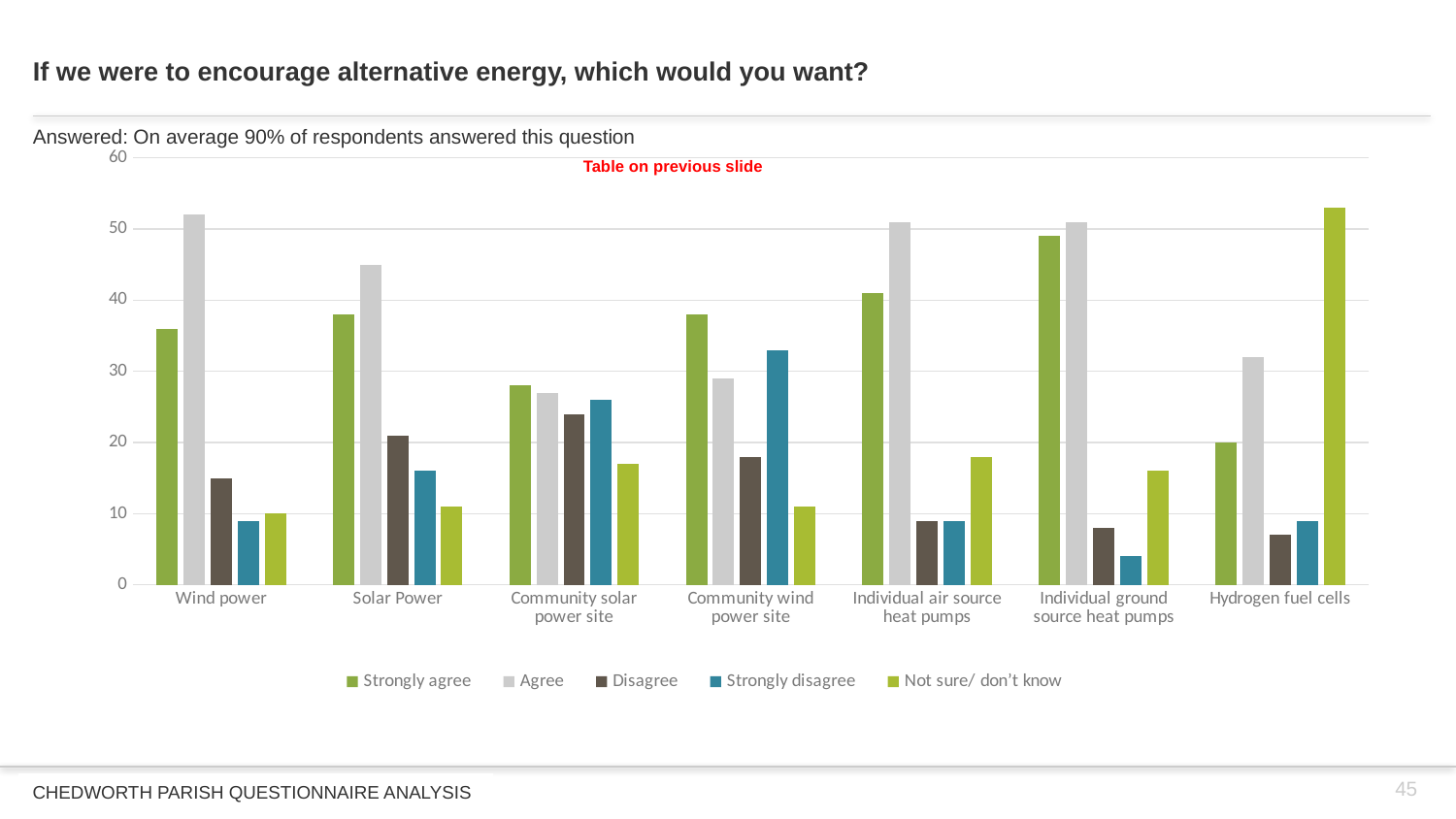
Is the 'Strongly disagree' value for Community solar power site greater or less than 20? greater Which energy option has the highest 'Strongly agree' bar? Individual ground source heat pumps Which energy option has the lowest 'Strongly disagree' bar? Individual ground source heat pumps How many series does the legend list? 5 Which is larger: the 'Agree' value for Wind power or the 'Agree' value for Solar Power? Wind power Is the 'Agree' value for Solar Power greater or less than 40? greater How many energy options (categories) are shown on the x axis? 7 Which is larger: the 'Strongly disagree' value for Community wind power site or for Community solar power site? Community wind power site Which energy option has the lowest 'Strongly agree' bar? Hydrogen fuel cells For Hydrogen fuel cells, which response has the tallest bar? Not sure/ don't know Which energy option has the highest 'Not sure/ don't know' bar? Hydrogen fuel cells What kind of chart is shown on the slide? Bar chart